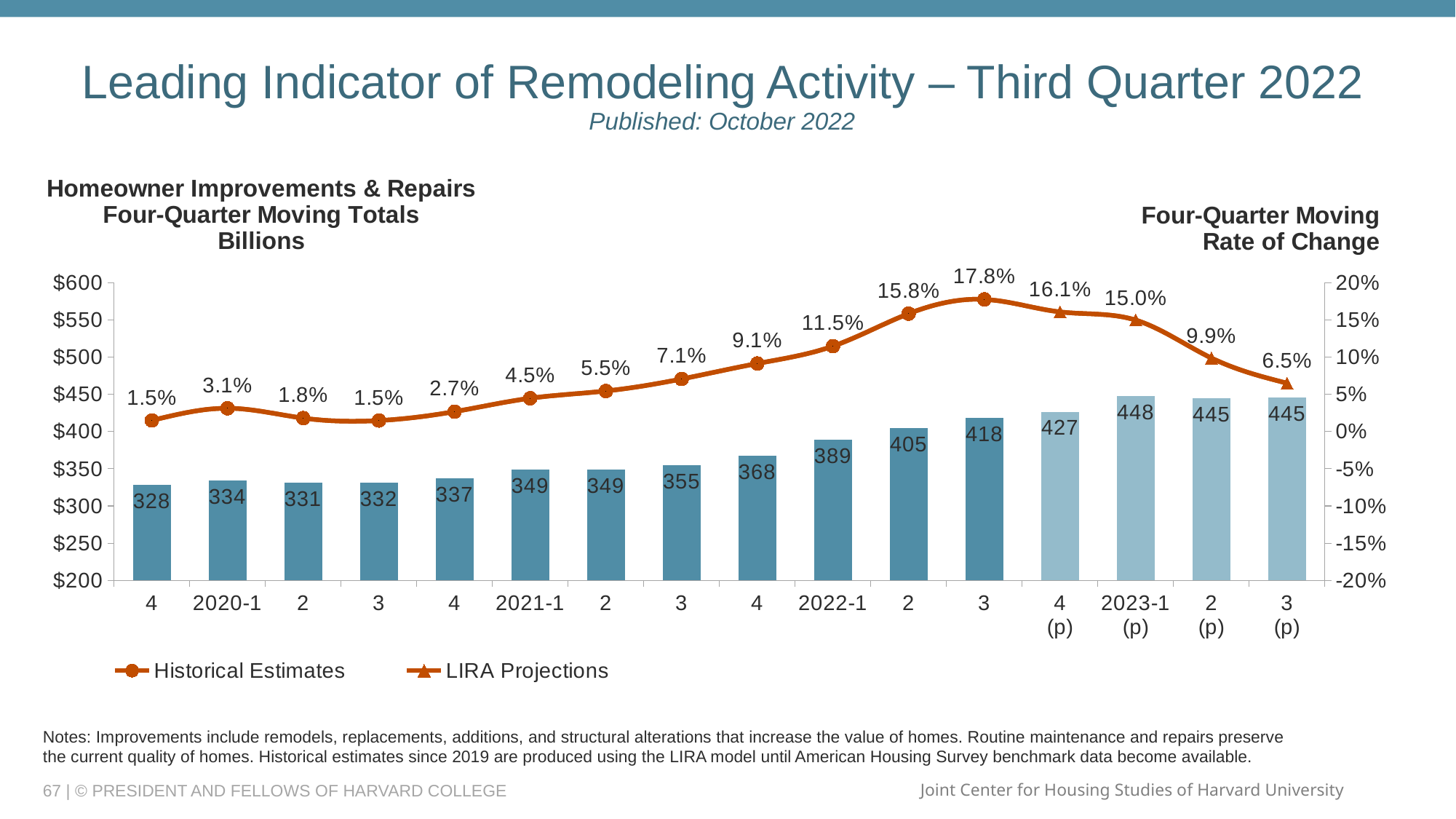
Which has a larger four-quarter moving total, 2021-4 or 2022-1? 2022-1 Does the four-quarter moving rate of change rise or fall from 2022-3 to 2023-3 (p)? Fall Which legend series is drawn with triangle markers? LIRA Projections What is the four-quarter moving rate of change for the third quarter of 2022 (2022-3)? 17.8% Which quarter has the highest four-quarter moving rate of change? 2022-3 (17.8%) How many series does the legend list? 2 What is the projected four-quarter moving rate of change for 2023-2 (p)? 9.9% What is the lowest four-quarter moving total shown on the bars? 328 What is the four-quarter moving total (in billions) for 2022-1? 389 How many bars (quarters) are plotted on the chart? 16 What is the difference between the four-quarter moving totals for 2023-1 (p) and 2022-3? 30 What kind of chart is shown on the slide? Combination bar and line chart